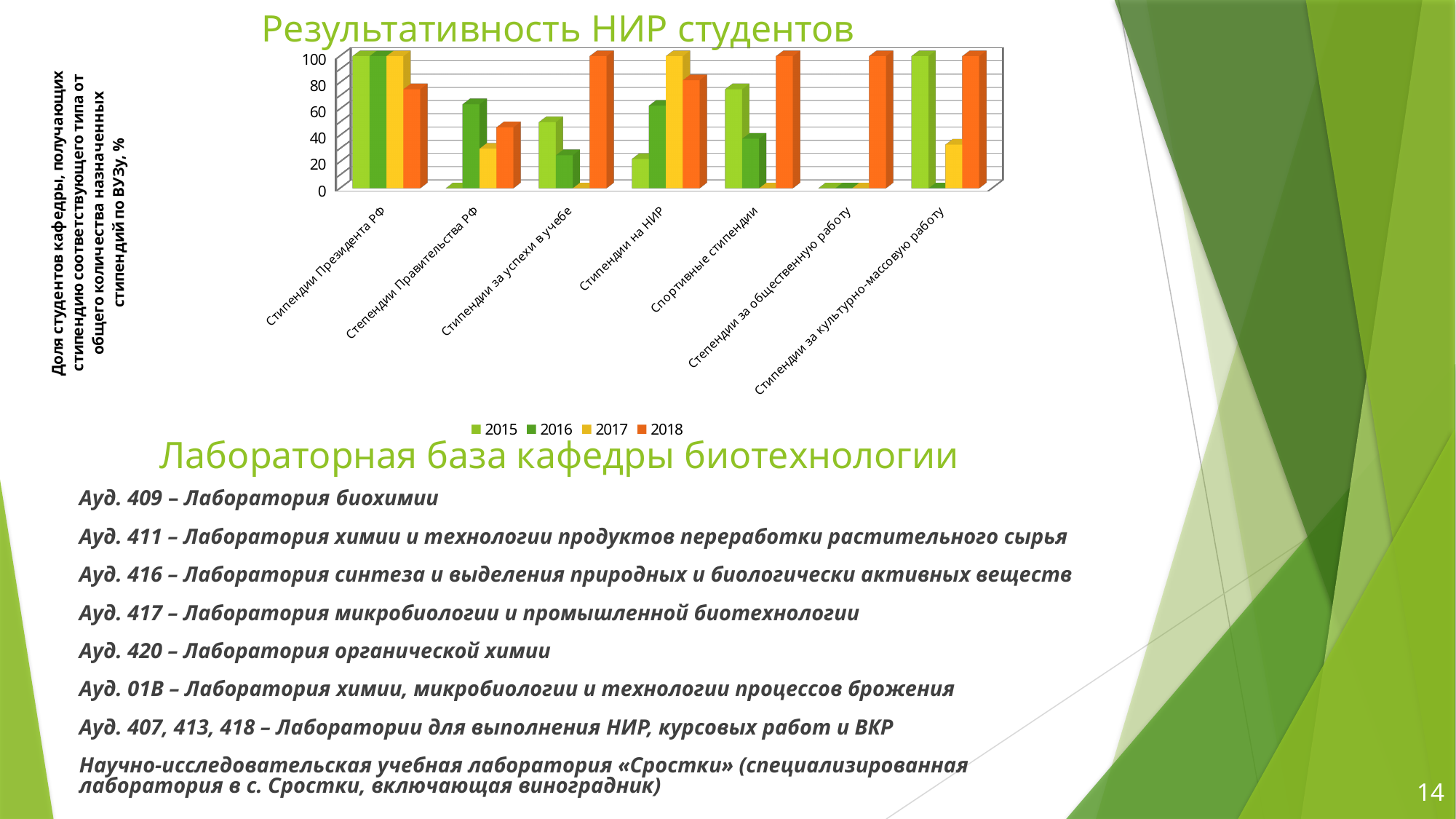
What is the title of the chart? Результативность НИР студентов How many scholarship categories are shown on the x axis of the chart? 7 What is the value for 2015 in the category Стипендии Правительства РФ? 0 Is the value for 2015 in the category Спортивные стипендии greater or less than 60? greater Which years are listed in the chart legend? 2015, 2016, 2017, 2018 What type of chart is shown on the slide? bar chart What is the value for 2017 in the category Стипендии на НИР? 100 How many series does the chart legend list? 4 In the category Стипендии Правительства РФ, which year has the highest value? 2016 In the category Спортивные стипендии, which is larger: the value for 2015 or the value for 2016? 2015 Is the value for 2015 in the category Стипендии на НИР greater or less than 40? less What is the value for 2018 in the category Стипендии за общественную работу? 100